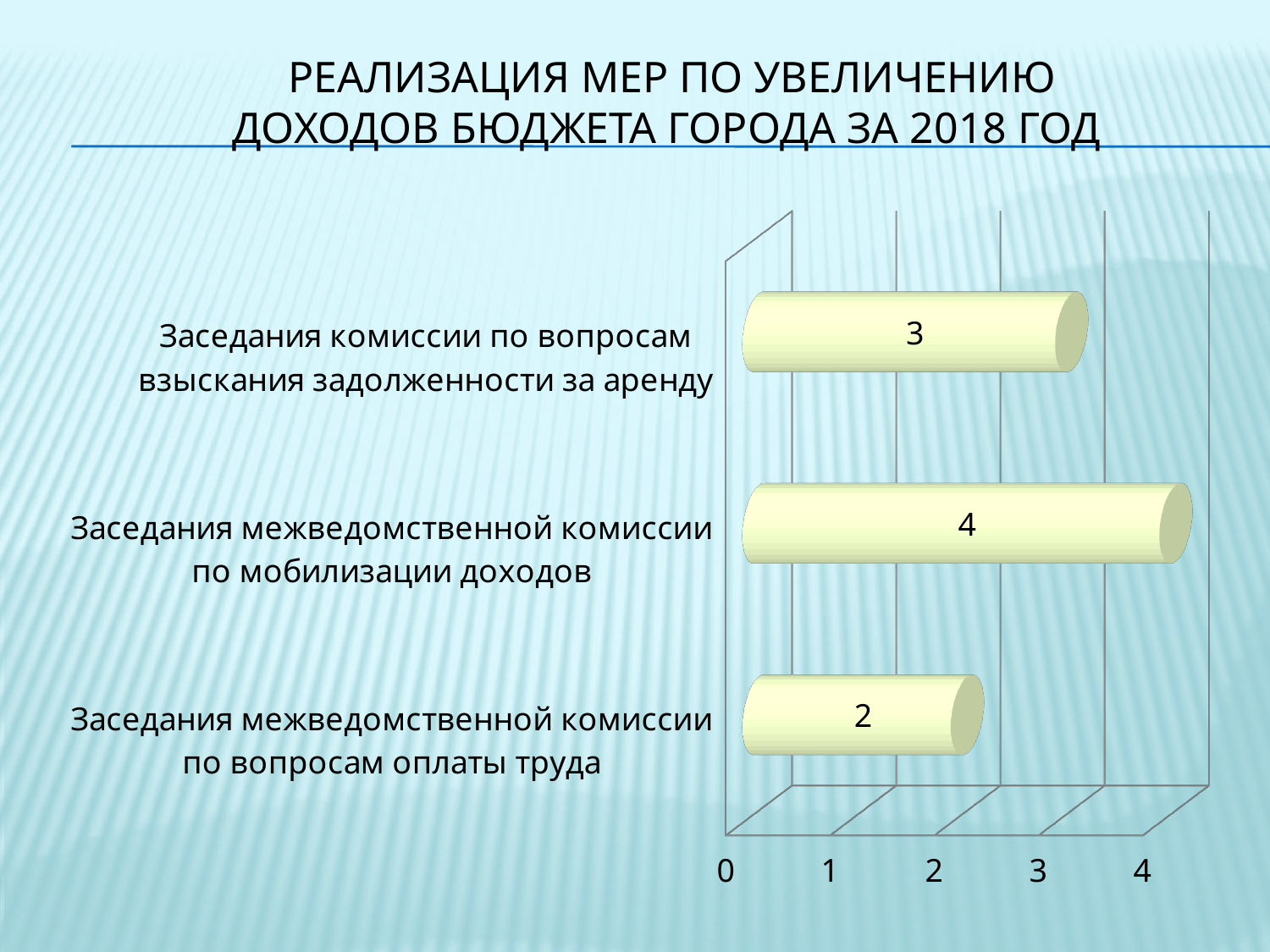
Is the value for «Заседания межведомственной комиссии по мобилизации доходов» greater or less than 3? greater What is the difference between the values for «Заседания межведомственной комиссии по мобилизации доходов» and «Заседания межведомственной комиссии по вопросам оплаты труда»? 2 What is the maximum value shown on the horizontal axis? 4 Which is larger: the value for «Заседания комиссии по вопросам взыскания задолженности за аренду» or for «Заседания межведомственной комиссии по вопросам оплаты труда»? Заседания комиссии по вопросам взыскания задолженности за аренду What is the title of the slide? Реализация мер по увеличению доходов бюджета города за 2018 год What is the value for «Заседания комиссии по вопросам взыскания задолженности за аренду»? 3 Which category has the lowest value? Заседания межведомственной комиссии по вопросам оплаты труда Which category has the highest value? Заседания межведомственной комиссии по мобилизации доходов What kind of chart is shown on the slide? bar chart What is the value for «Заседания межведомственной комиссии по мобилизации доходов»? 4 What is the value for «Заседания межведомственной комиссии по вопросам оплаты труда»? 2 How many categories are shown in the chart? 3